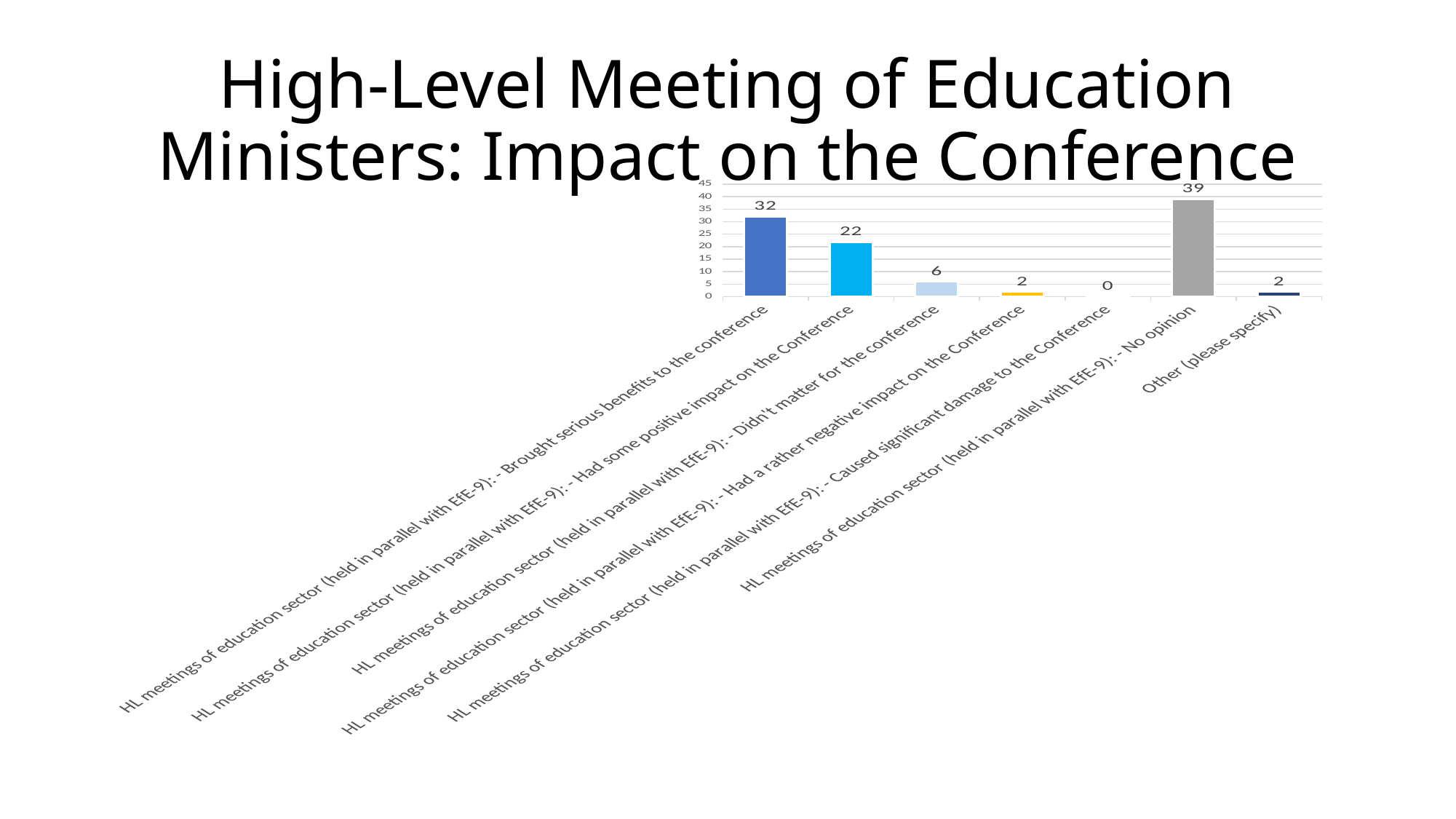
What kind of chart is shown on the slide? bar chart What is the value for 'Caused significant damage to the Conference'? 0 Which category has the lowest value? Caused significant damage to the Conference Which category has the highest value? No opinion Which is larger, the value for 'Had some positive impact on the Conference' or the value for 'Didn't matter for the conference'? Had some positive impact on the Conference How many categories are plotted in the chart? 7 What is the title of the slide containing the chart? High-Level Meeting of Education Ministers: Impact on the Conference What is the value for 'Had some positive impact on the Conference'? 22 What is the value for 'Brought serious benefits to the conference'? 32 What is the value for 'No opinion'? 39 What is the value for 'Didn't matter for the conference'? 6 What is the difference between the values for 'No opinion' and 'Brought serious benefits to the conference'? 7